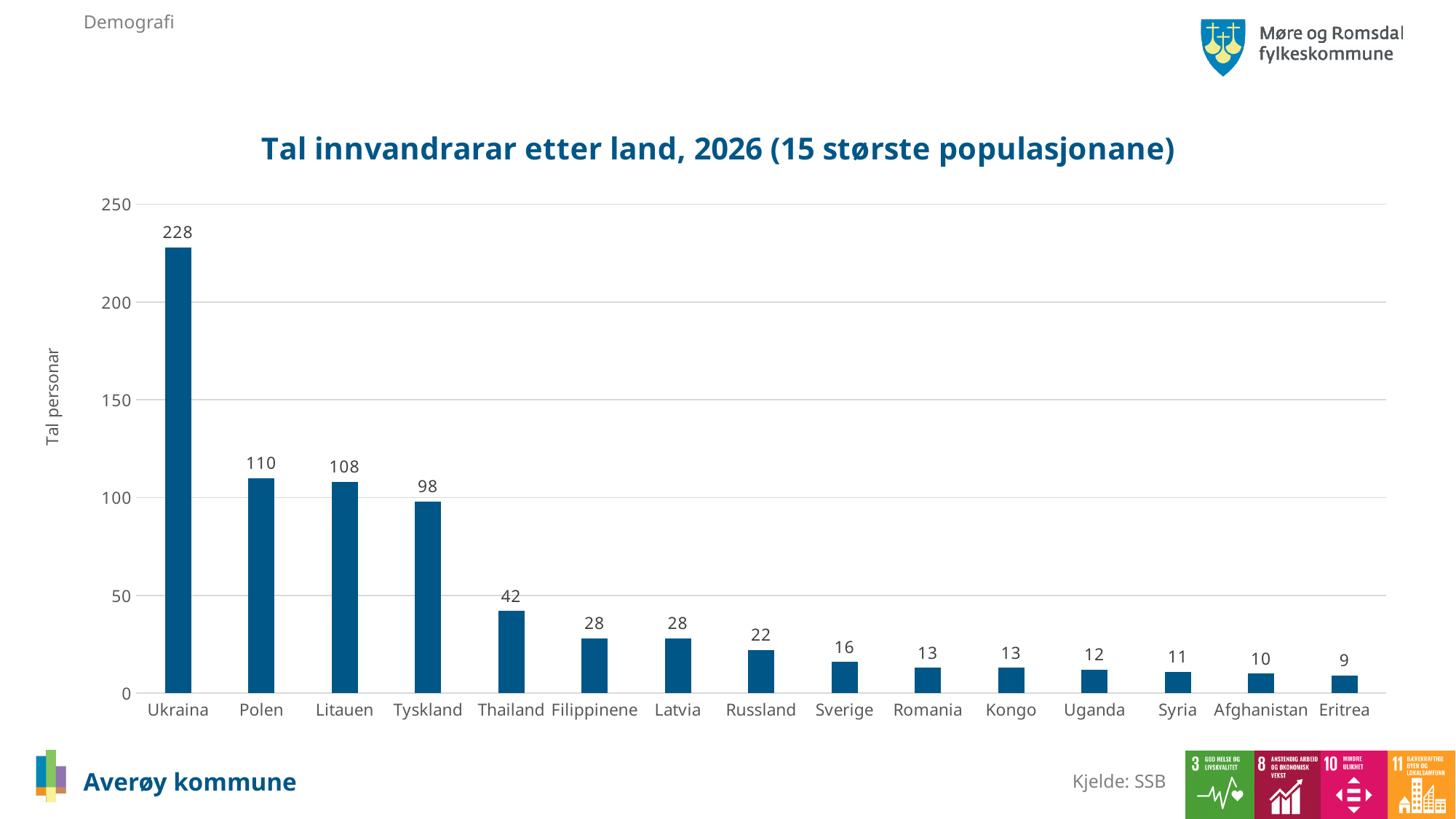
What is the title of the chart? Tal innvandrarar etter land, 2026 (15 største populasjonane) What is the value for Russland? 22 How many countries are shown on the x axis? 15 What is the difference between the values for Ukraina and Polen? 118 What is the value for Ukraina? 228 Is the value for Litauen greater or less than 100? greater Which country has the highest value? Ukraina What is the difference between the values for Thailand and Filippinene? 14 Which is larger, the value for Polen or the value for Tyskland? Polen What is the value for Tyskland? 98 Which country has the lowest value? Eritrea What kind of chart is shown on the slide? bar chart